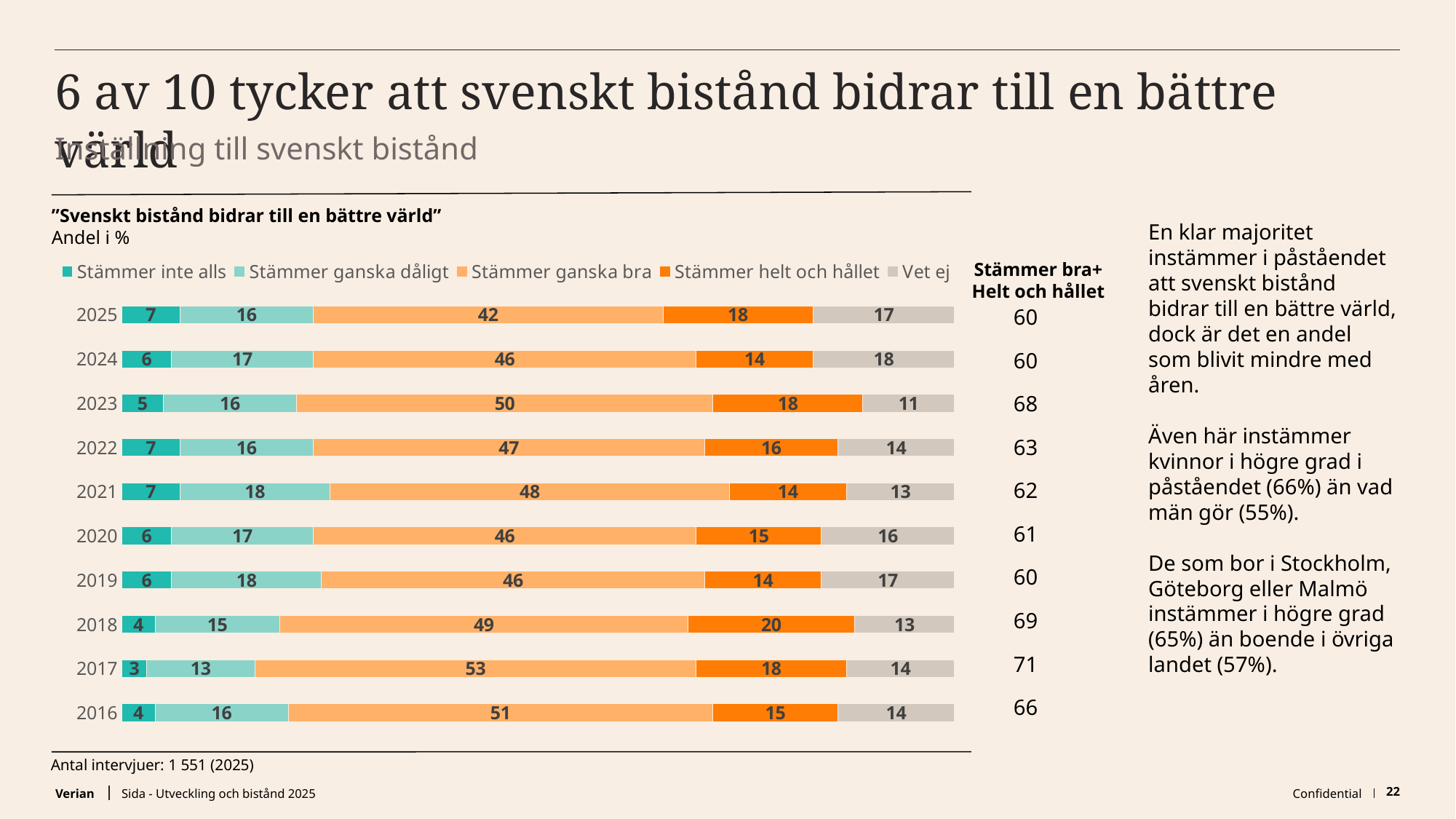
What is the total of the stacked bar for 2025? 100 Which is larger: the "Stämmer helt och hållet" value for 2025 or for 2024? 2025 How many series does the legend list? 5 In which year is the value for "Stämmer ganska bra" highest? 2017 How many years are shown in the chart? 10 What is the value for "Stämmer ganska bra" in 2025? 42 In which year is the value for "Stämmer inte alls" lowest? 2017 What is the "Stämmer bra+Helt och hållet" value shown for 2017? 71 What is the difference between the "Stämmer ganska bra" values for 2017 and 2025? 11 What is the value for "Stämmer helt och hållet" in 2018? 20 What kind of chart is shown on the slide? stacked bar chart What is the value for "Vet ej" in 2023? 11